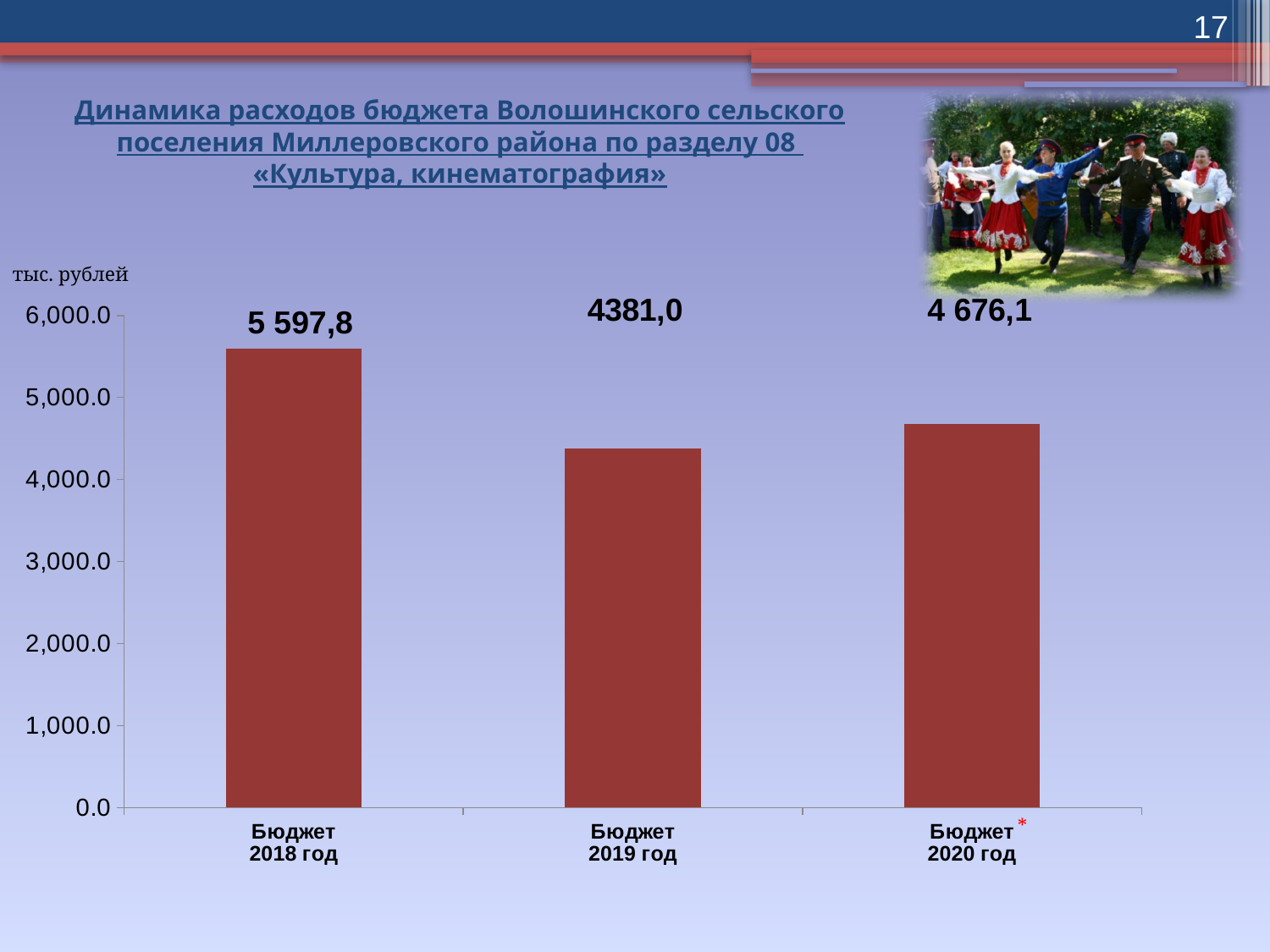
Is the value for Бюджет 2018 год greater or less than 5,000.0? greater What is the difference between the values for Бюджет 2020 год and Бюджет 2019 год? 295,1 How many bars are shown in the chart? 3 Which is larger, the value for Бюджет 2020 год or Бюджет 2019 год? Бюджет 2020 год What is the value for Бюджет 2020 год? 4 676,1 What is the value for Бюджет 2019 год? 4381,0 Which year has the lowest budget expenditure? Бюджет 2019 год What is the value for Бюджет 2018 год? 5 597,8 Which year has the highest budget expenditure? Бюджет 2018 год What kind of chart is shown on the slide? bar chart What is the difference between the values for Бюджет 2018 год and Бюджет 2019 год? 1 216,8 Do the values rise or fall from Бюджет 2019 год to Бюджет 2020 год? rise